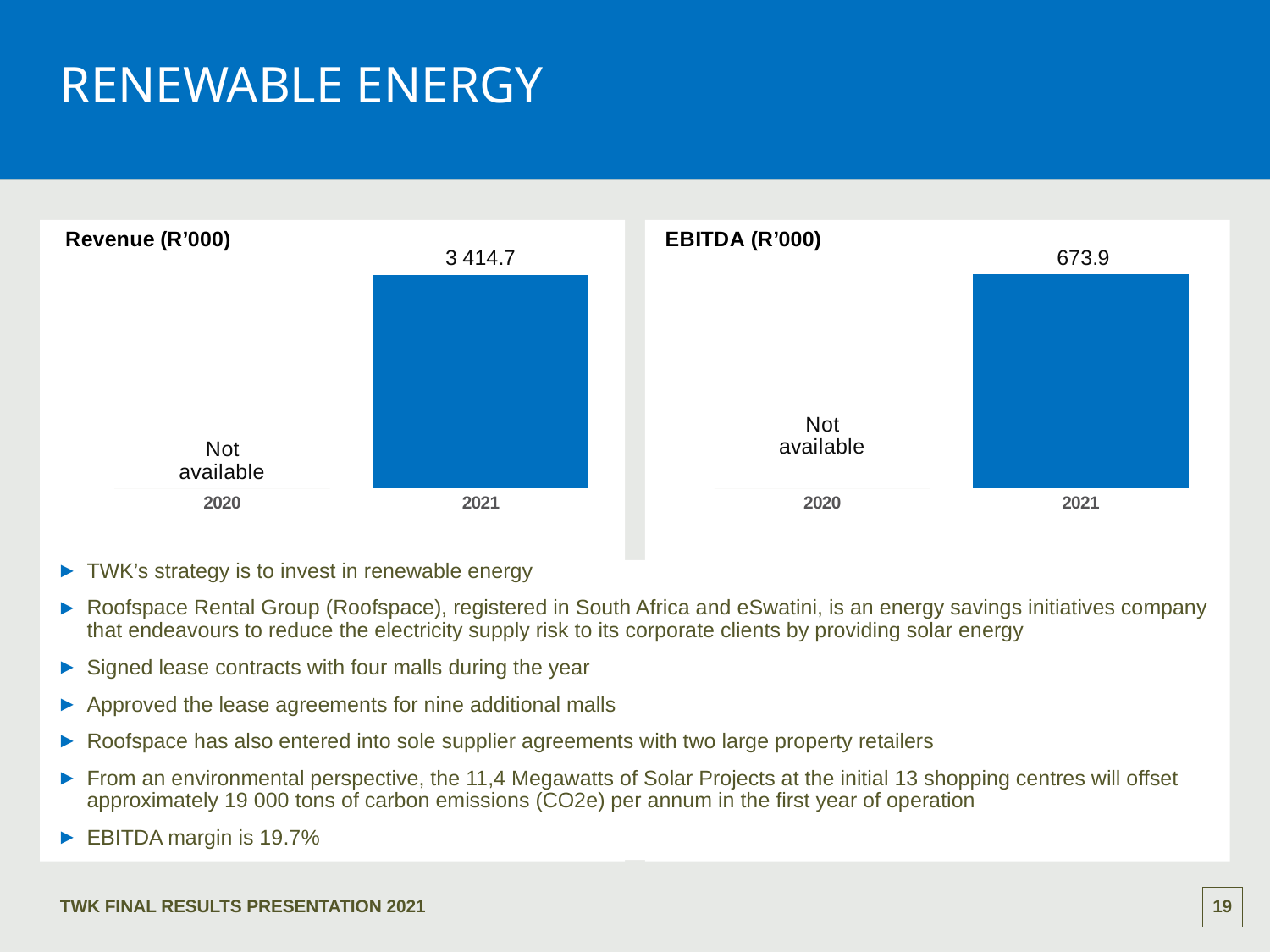
How many categories are on the x axis of the EBITDA (R'000) chart? 2 What kind of chart is the EBITDA (R'000) chart? Bar chart Is the 2021 value in the Revenue (R'000) chart larger than the 2021 value in the EBITDA (R'000) chart? Yes How many categories are on the x axis of the Revenue (R'000) chart? 2 In the Revenue (R'000) chart, what is the value for 2021? 3 414.7 Which years are shown on the x axis of the EBITDA (R'000) chart? 2020 and 2021 What is the title of the chart on the left of the slide? Revenue (R'000) In the Revenue (R'000) chart, what is shown for 2020? Not available In the EBITDA (R'000) chart, what is shown for 2020? Not available In the EBITDA (R'000) chart, what is the value for 2021? 673.9 What kind of chart is the Revenue (R'000) chart? Bar chart